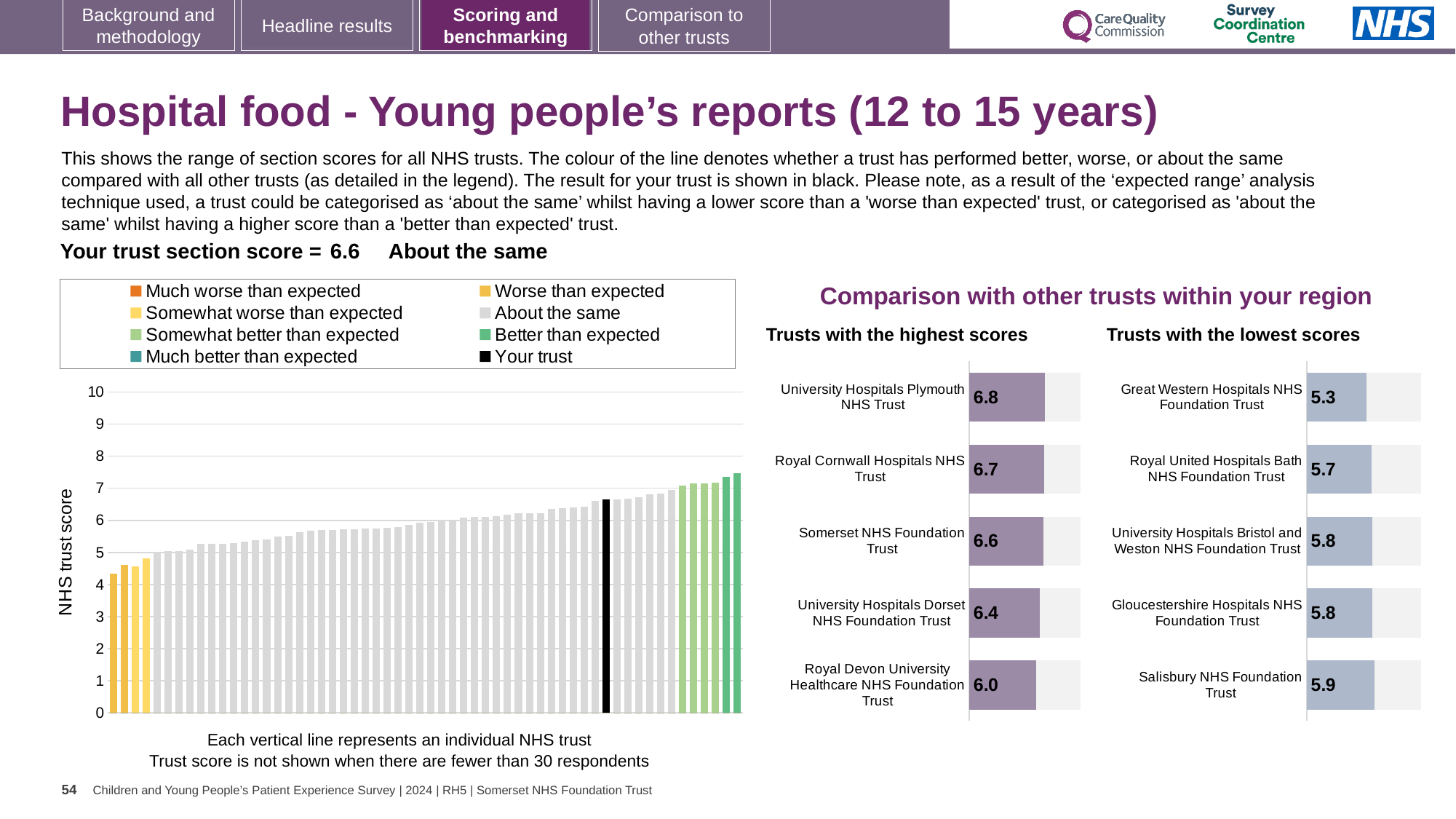
In the 'Trusts with the highest scores' chart, which trust has the highest score? University Hospitals Plymouth NHS Trust In the 'Trusts with the lowest scores' chart, what is the score for Great Western Hospitals NHS Foundation Trust? 5.3 In the 'Trusts with the lowest scores' chart, what is the score for Gloucestershire Hospitals NHS Foundation Trust? 5.8 In the 'Trusts with the highest scores' chart, what is the score for University Hospitals Plymouth NHS Trust? 6.8 In the 'NHS trust score' chart on the left, is the value of the black 'Your trust' bar greater or less than 6? greater How many trusts are shown in the 'Trusts with the highest scores' chart? 5 In the 'Trusts with the lowest scores' chart, which trust has the lowest score? Great Western Hospitals NHS Foundation Trust In the 'Trusts with the highest scores' chart, what is the difference between the scores of University Hospitals Plymouth NHS Trust and Royal Devon University Healthcare NHS Foundation Trust? 0.8 In the 'NHS trust score' chart on the left, do the bar values rise or fall from left to right? rise How many entries does the legend of the 'NHS trust score' chart on the left list? 8 What kind of chart is the 'NHS trust score' chart on the left of the slide? bar chart In the 'Trusts with the lowest scores' chart, which has the larger score: Royal United Hospitals Bath NHS Foundation Trust or Salisbury NHS Foundation Trust? Salisbury NHS Foundation Trust